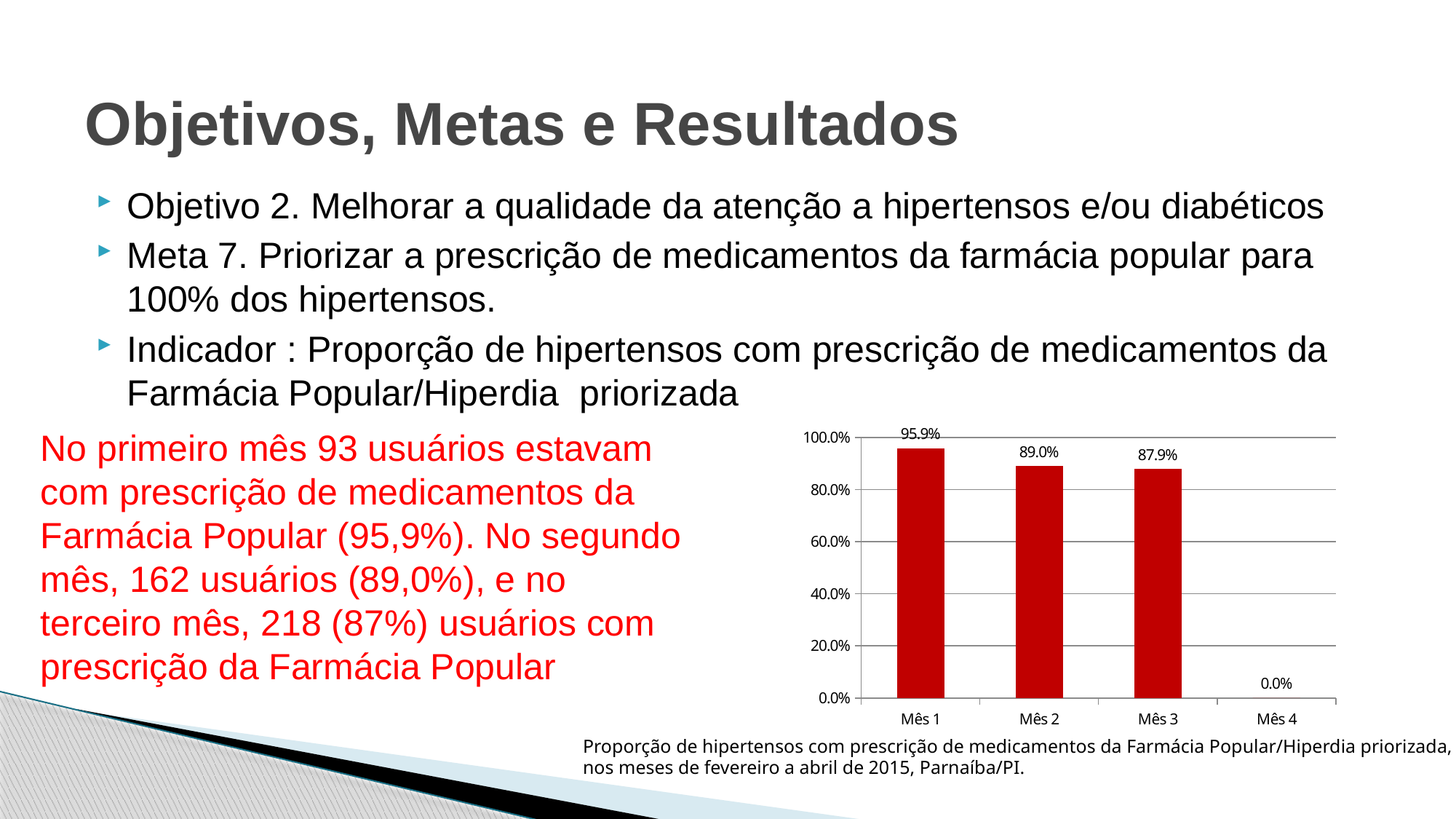
What is the value for Mês 2? 89.0% Which is larger, the value for Mês 1 or the value for Mês 3? Mês 1 What is the difference between the values for Mês 1 and Mês 2? 6.9% What is the value for Mês 3? 87.9% What is the difference between the values for Mês 2 and Mês 3? 1.1% What is the value for Mês 1? 95.9% Which month has the lowest value? Mês 4 Which month has the highest value? Mês 1 What is the value for Mês 4? 0.0% What kind of chart is shown on the slide? bar chart How many months are shown on the x axis of the chart? 4 Is the value for Mês 3 greater or less than 80.0%? greater